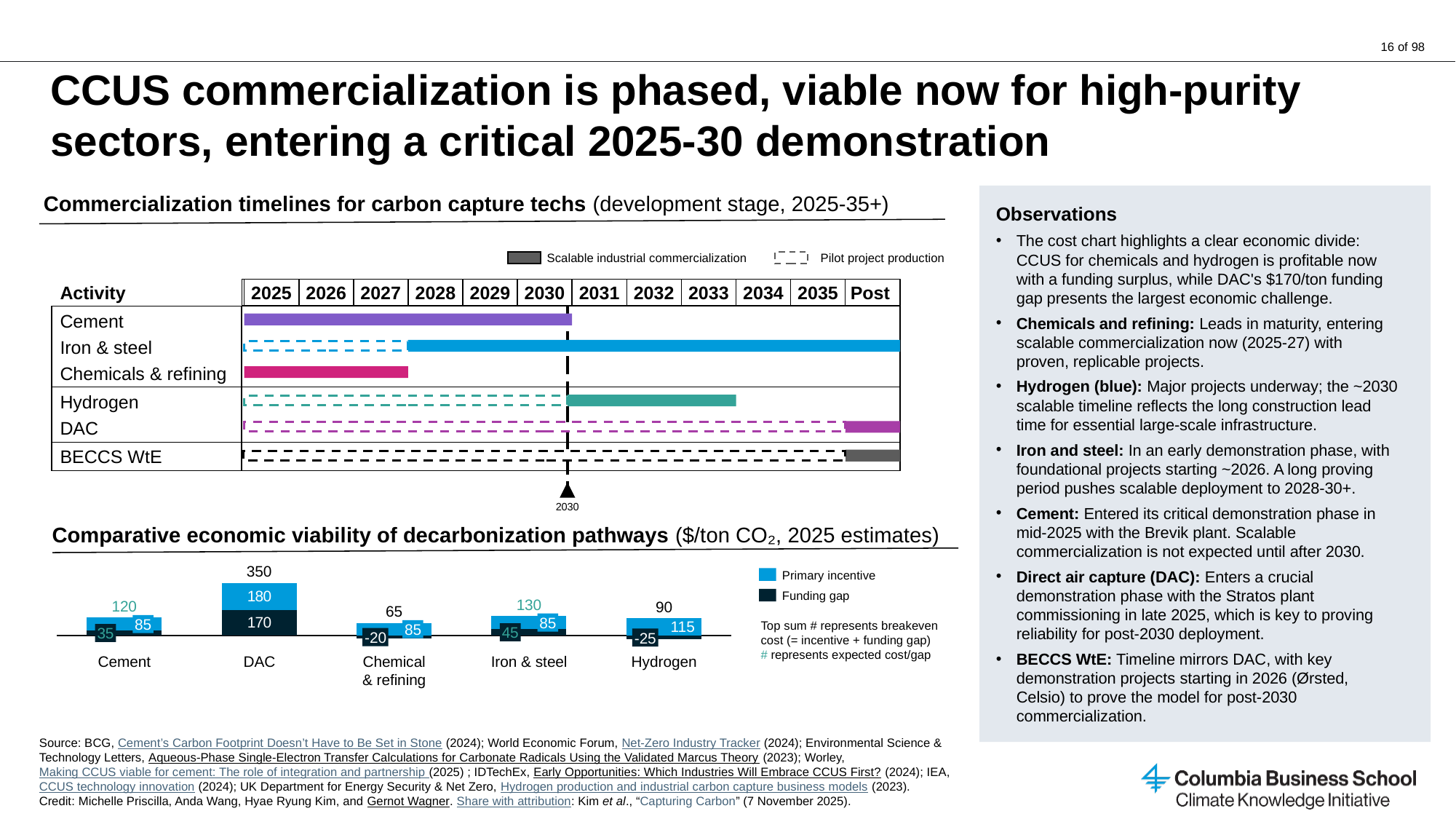
On the 'Comparative economic viability of decarbonization pathways' chart, what is the difference between the Funding gap for DAC and the Funding gap for Iron & steel? 125 On the 'Comparative economic viability of decarbonization pathways' chart, what is the Funding gap value for Cement? 35 On the 'Comparative economic viability of decarbonization pathways' chart, which pathway has the highest breakeven cost (top sum)? DAC How many series does the legend of the 'Comparative economic viability of decarbonization pathways' chart list? 2 How many pathways (categories) are shown on the 'Comparative economic viability of decarbonization pathways' chart? 5 On the 'Comparative economic viability of decarbonization pathways' chart, which pathway has the lowest breakeven cost (top sum)? Chemical & refining On the 'Comparative economic viability of decarbonization pathways' chart, what is the Primary incentive value for DAC? 180 On the 'Comparative economic viability of decarbonization pathways' chart, what is the Funding gap value for Hydrogen? -25 What kind of chart is the 'Comparative economic viability of decarbonization pathways' chart? Stacked bar chart On the 'Comparative economic viability of decarbonization pathways' chart, what is the total breakeven cost shown above the Iron & steel bar? 130 On the 'Comparative economic viability of decarbonization pathways' chart, which is larger: the Primary incentive for Hydrogen or the Primary incentive for Cement? Hydrogen On the 'Commercialization timelines for carbon capture techs' chart, how many activities are listed? 6